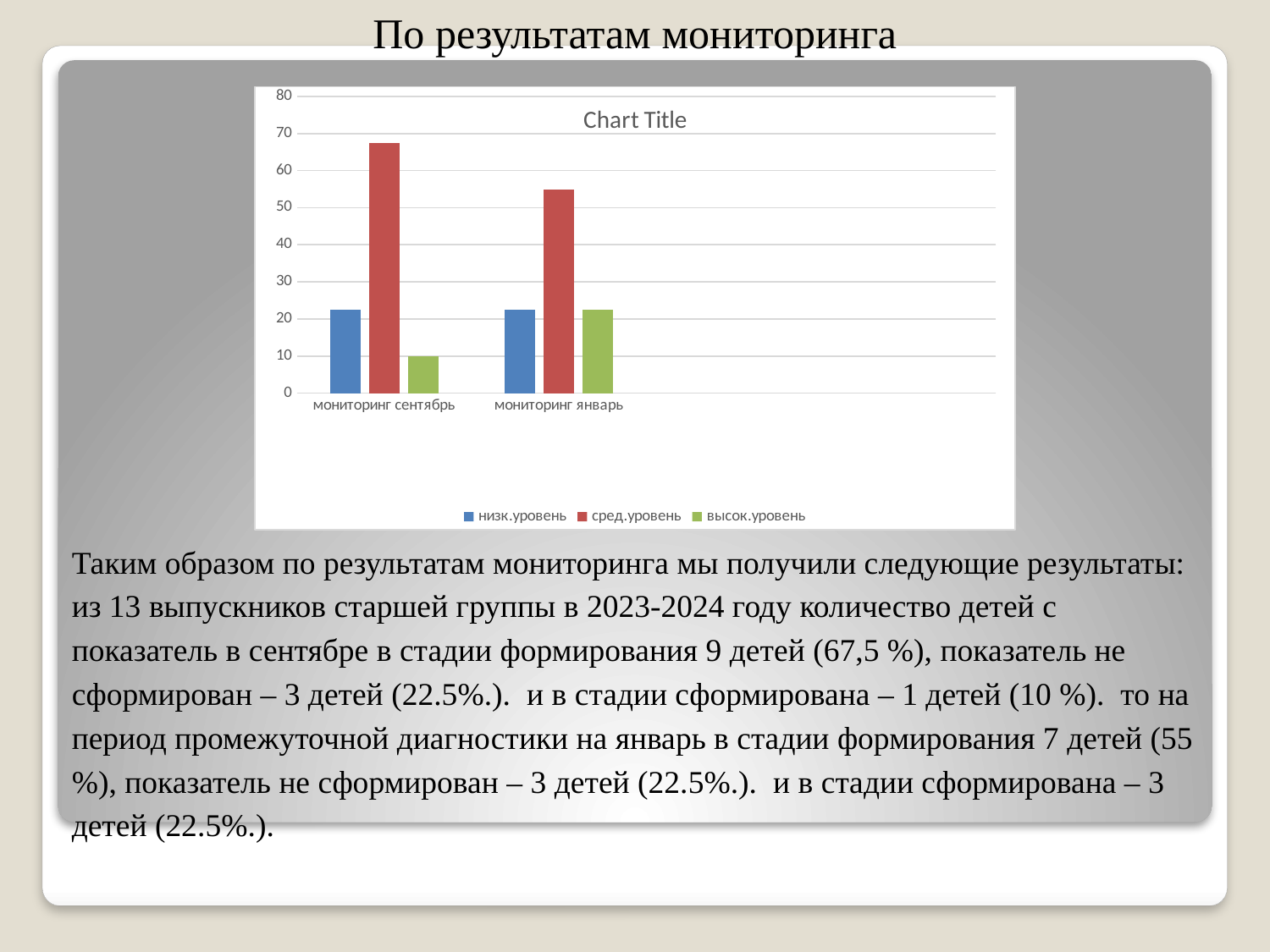
Is сред.уровень larger for мониторинг сентябрь or for мониторинг январь? мониторинг сентябрь Is the value of сред.уровень for мониторинг январь greater or less than 60? less How many categories are shown on the x axis of the chart? 2 What is the value of высок.уровень for мониторинг сентябрь? 10 Is the value of низк.уровень for мониторинг январь greater or less than 20? greater Which series has the highest value for мониторинг сентябрь? сред.уровень What kind of chart is shown on the slide? bar chart Is the value of сред.уровень for мониторинг сентябрь greater or less than 60? greater Which series has the highest value for мониторинг январь? сред.уровень Which series has the lowest value for мониторинг сентябрь? высок.уровень How many series does the chart legend list? 3 What is the title shown on the chart? Chart Title